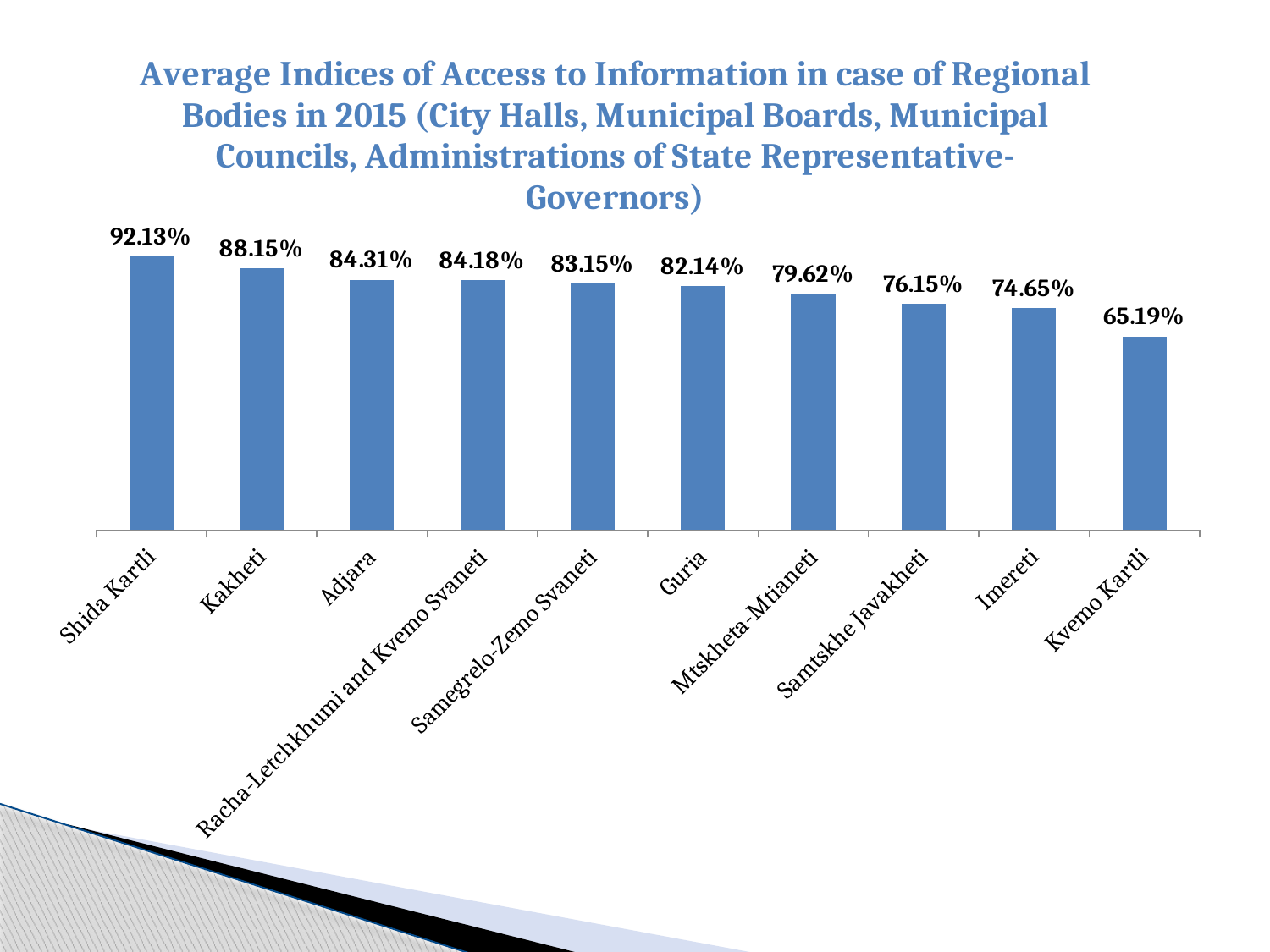
What is the value for Samegrelo-Zemo Svaneti? 83.15% What is the difference between the values for Kakheti and Imereti? 13.50 percentage points What kind of chart is shown on the slide? Bar chart What is the difference between the values for Shida Kartli and Kvemo Kartli? 26.94 percentage points Which is larger, the value for Guria or the value for Samtskhe Javakheti? Guria What is the value for Kvemo Kartli? 65.19% What is the value for Shida Kartli? 92.13% Which region has the lowest average index? Kvemo Kartli How many regions are shown in the chart? 10 Which region has the highest average index? Shida Kartli Do the values rise or fall from left to right across the chart? Fall What is the value for Mtskheta-Mtianeti? 79.62%